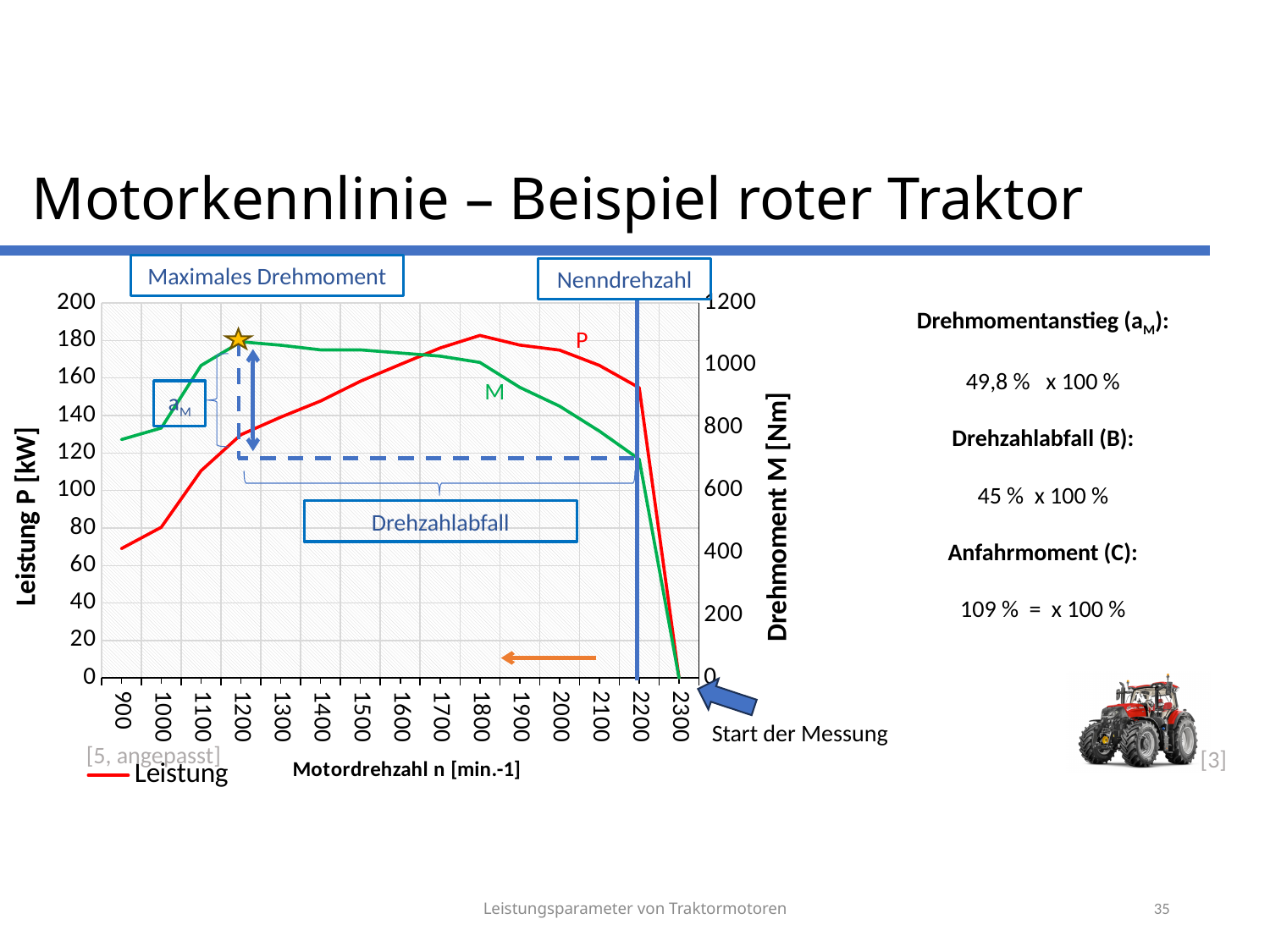
Does the Drehmoment (M) curve rise or fall between 1200 and 2200 min-1? fall What is the label of the x axis of the chart? Motordrehzahl n [min.-1] Is the Drehmoment (M) value at 900 min-1 greater or less than 600 Nm? greater Does the Leistung (P) curve rise or fall between 900 and 1800 min-1? rise What kind of chart is shown on the slide? line chart Is the Drehmoment (M) value at 1200 min-1 greater or less than 1000 Nm? greater How many lines (series) are plotted in the chart? 2 What is the title of the slide containing the chart? Motorkennlinie – Beispiel roter Traktor Is the Leistung (P) value at 900 min-1 greater or less than 80 kW? less At which engine speed is the maximum Drehmoment (marked with a star) reached? 1200